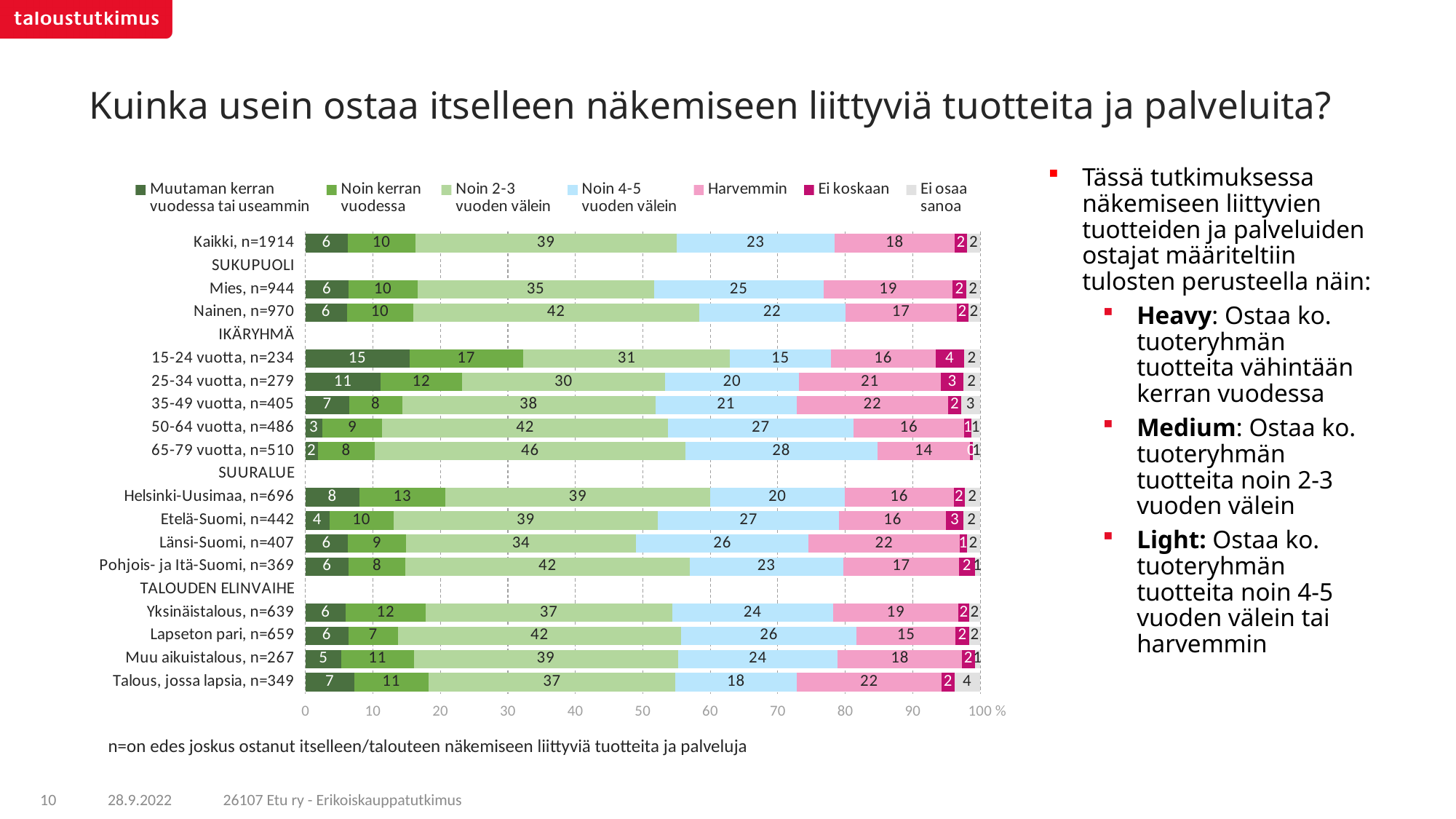
Which has a larger 'Noin kerran vuodessa' value: 'Helsinki-Uusimaa, n=696' or 'Pohjois- ja Itä-Suomi, n=369'? Helsinki-Uusimaa, n=696 Which group has the highest 'Noin 2-3 vuoden välein' value? 65-79 vuotta, n=510 What percentage of the 'Kaikki, n=1914' group falls in the 'Noin 2-3 vuoden välein' category? 39 What is the 'Muutaman kerran vuodessa tai useammin' value for '15-24 vuotta, n=234'? 15 How many series does the legend list? 7 How many respondent groups (bars) are plotted in the chart? 16 What is the difference between the 'Noin 4-5 vuoden välein' values for 'Mies, n=944' and 'Nainen, n=970'? 3 What is the 'Harvemmin' value for 'Talous, jossa lapsia, n=349'? 22 What is the title of the chart on the slide? Kuinka usein ostaa itselleen näkemiseen liittyviä tuotteita ja palveluita? What is the 'Ei koskaan' value for '15-24 vuotta, n=234'? 4 What kind of chart is shown on the slide? Stacked bar chart Which age group has the lowest 'Muutaman kerran vuodessa tai useammin' value? 65-79 vuotta, n=510